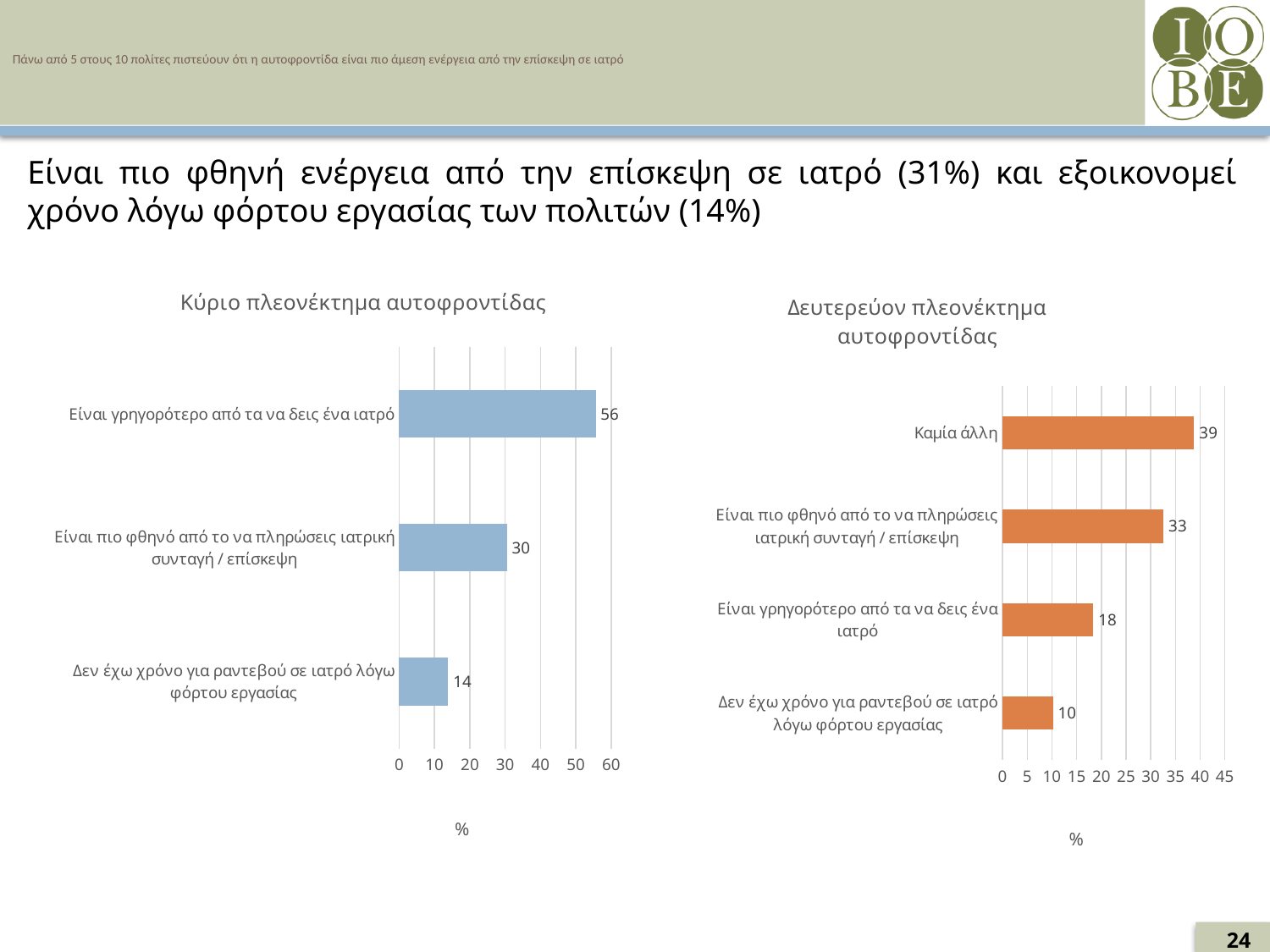
In the chart titled "Κύριο πλεονέκτημα αυτοφροντίδας", which category has the lowest value? Δεν έχω χρόνο για ραντεβού σε ιατρό λόγω φόρτου εργασίας In the chart titled "Δευτερεύον πλεονέκτημα αυτοφροντίδας", what is the value for "Είναι γρηγορότερο από τα να δεις ένα ιατρό"? 18 In the chart titled "Δευτερεύον πλεονέκτημα αυτοφροντίδας", what is the difference between "Καμία άλλη" and "Δεν έχω χρόνο για ραντεβού σε ιατρό λόγω φόρτου εργασίας"? 29 In the chart titled "Κύριο πλεονέκτημα αυτοφροντίδας", what is the value for "Δεν έχω χρόνο για ραντεβού σε ιατρό λόγω φόρτου εργασίας"? 14 In the chart titled "Δευτερεύον πλεονέκτημα αυτοφροντίδας", which category has the highest value? Καμία άλλη What kind of chart is the chart titled "Κύριο πλεονέκτημα αυτοφροντίδας"? Bar chart In the chart titled "Δευτερεύον πλεονέκτημα αυτοφροντίδας", which is larger: "Είναι πιο φθηνό από το να πληρώσεις ιατρική συνταγή / επίσκεψη" or "Δεν έχω χρόνο για ραντεβού σε ιατρό λόγω φόρτου εργασίας"? Είναι πιο φθηνό από το να πληρώσεις ιατρική συνταγή / επίσκεψη In the chart titled "Κύριο πλεονέκτημα αυτοφροντίδας", how many categories are shown? 3 In the chart titled "Δευτερεύον πλεονέκτημα αυτοφροντίδας", how many categories are shown? 4 In the chart titled "Κύριο πλεονέκτημα αυτοφροντίδας", what is the difference between "Είναι γρηγορότερο από τα να δεις ένα ιατρό" and "Είναι πιο φθηνό από το να πληρώσεις ιατρική συνταγή / επίσκεψη"? 26 In the chart titled "Δευτερεύον πλεονέκτημα αυτοφροντίδας", what is the value for "Καμία άλλη"? 39 In the chart titled "Κύριο πλεονέκτημα αυτοφροντίδας", what is the value for "Είναι γρηγορότερο από τα να δεις ένα ιατρό"? 56